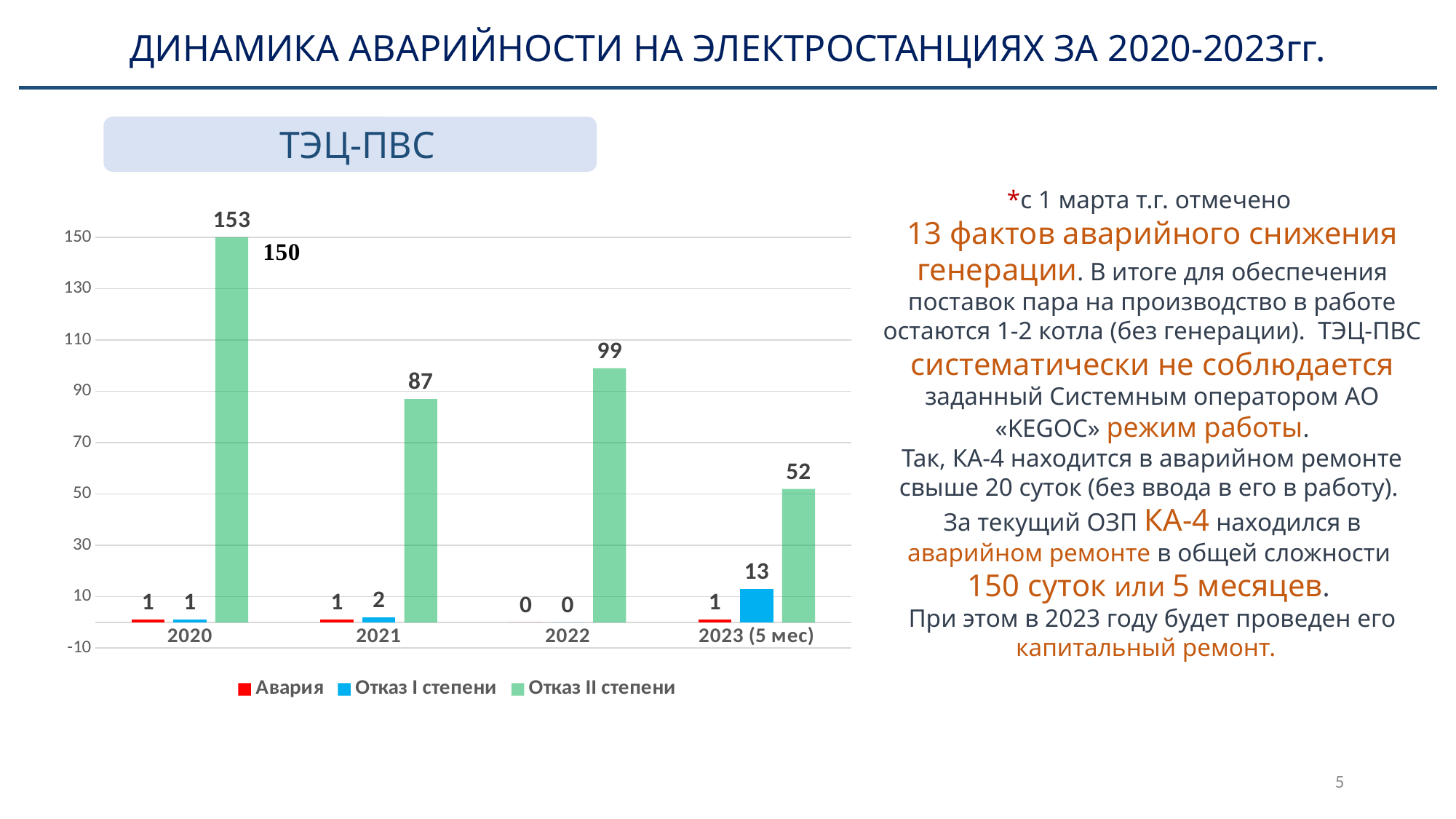
In which year is the Отказ II степени value the highest? 2020 What is the value of Отказ II степени for 2021? 87 Which year has the larger Отказ II степени value, 2021 or 2022? 2022 What is the difference between the Отказ II степени values for 2022 and 2021? 12 What is the value of Отказ II степени for 2022? 99 What kind of chart is shown on the slide? bar chart What is the value of Отказ II степени for 2023 (5 мес)? 52 In which category is the Отказ II степени value the lowest? 2023 (5 мес) How many year categories are shown on the x axis of the chart? 4 How many series does the chart legend list? 3 What is the value of Авария for 2022? 0 What is the value of Отказ I степени for 2023 (5 мес)? 13